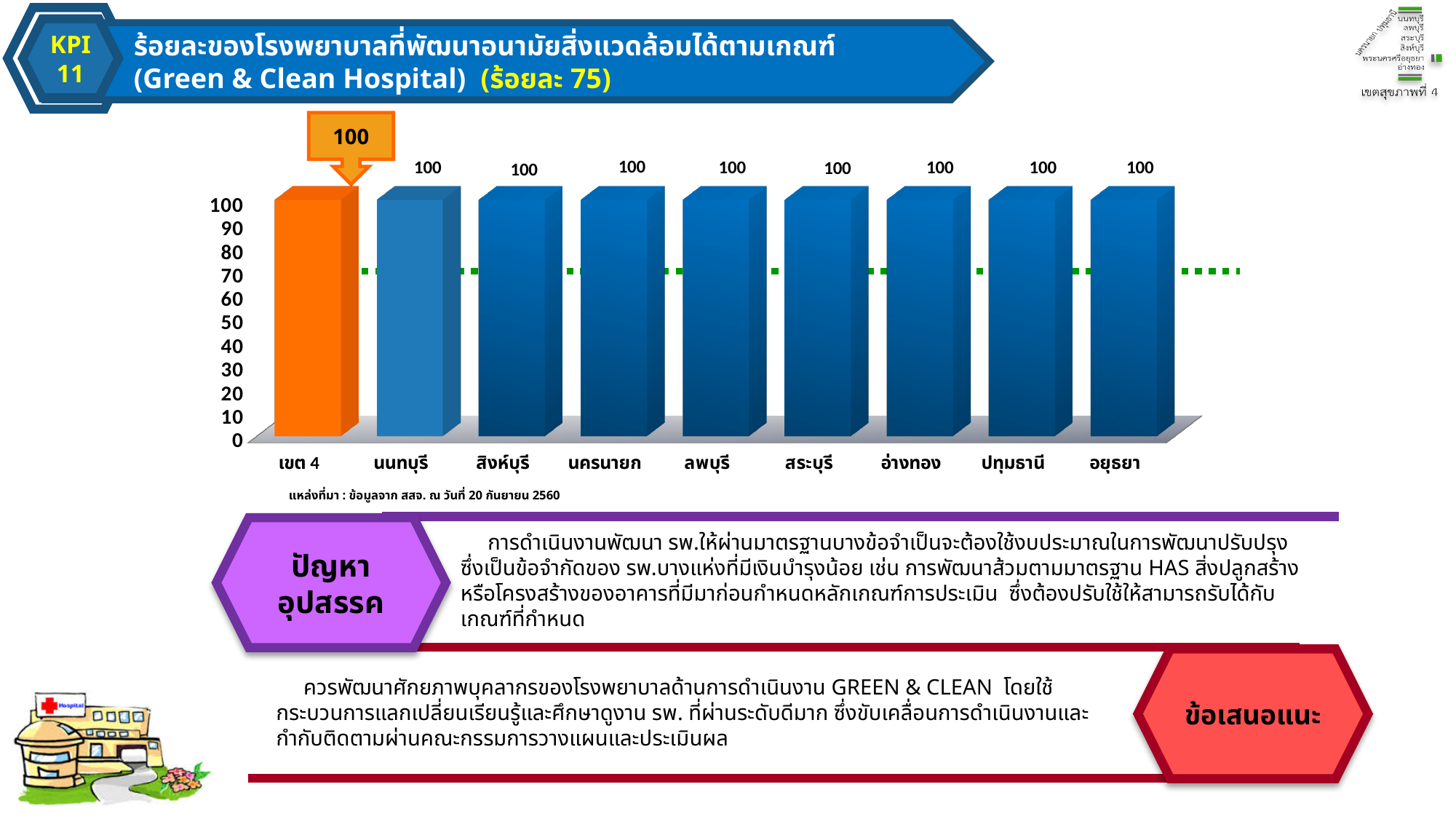
What is the value for นนทบุรี? 100 What target percentage is stated in the chart title (ร้อยละ)? 75 What is the value for สระบุรี? 100 What is the value for อยุธยา? 100 What is the value for เขต 4? 100 What kind of chart is shown on the slide? bar chart Is the value for อ่างทอง greater or less than 50? greater Is the value for ลพบุรี greater or less than 70? greater What is the difference between the values for นครนายก and ปทุมธานี? 0 Do the values rise, fall, or stay the same across the categories from เขต 4 to อยุธยา? stay the same Which category's bar is coloured orange? เขต 4 How many categories are shown on the x axis of the chart? 9